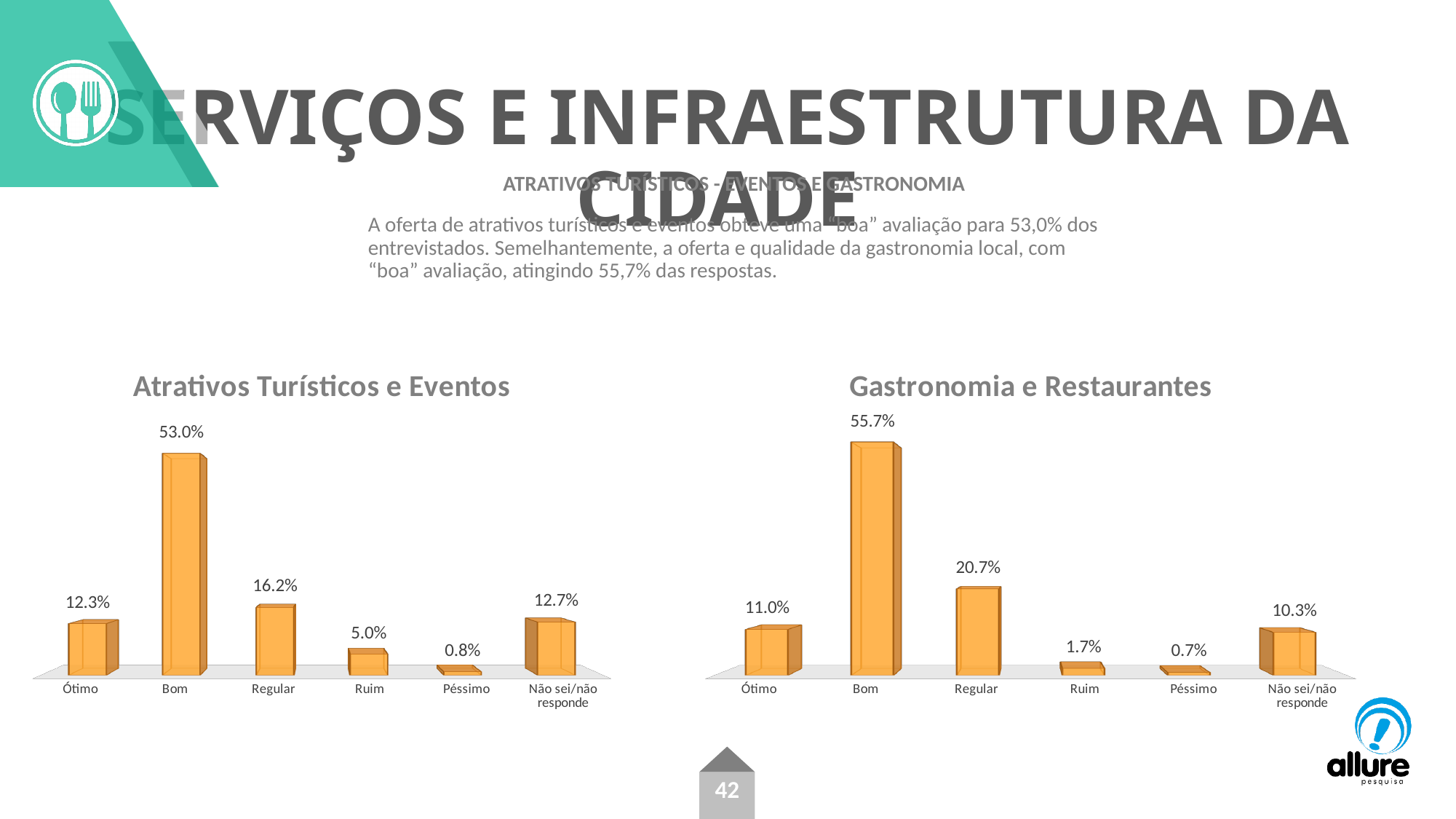
In the 'Gastronomia e Restaurantes' chart, which category has the highest value? Bom In the 'Gastronomia e Restaurantes' chart, which is larger: the value for Ruim or the value for Péssimo? Ruim In the 'Atrativos Turísticos e Eventos' chart, which category has the lowest value? Péssimo In the 'Atrativos Turísticos e Eventos' chart, what is the value for Não sei/não responde? 12.7% What kind of chart is the 'Atrativos Turísticos e Eventos' chart? Bar chart In the 'Atrativos Turísticos e Eventos' chart, what is the value for Bom? 53.0% In the 'Atrativos Turísticos e Eventos' chart, what is the difference between the values for Regular and Ruim? 11.2% What is the title of the chart on the right side of the slide? Gastronomia e Restaurantes In the 'Gastronomia e Restaurantes' chart, what is the value for Regular? 20.7% In the 'Gastronomia e Restaurantes' chart, what is the difference between the values for Bom and Ótimo? 44.7% In the 'Atrativos Turísticos e Eventos' chart, which is larger: the value for Ótimo or the value for Não sei/não responde? Não sei/não responde How many categories are shown in the 'Gastronomia e Restaurantes' chart? 6